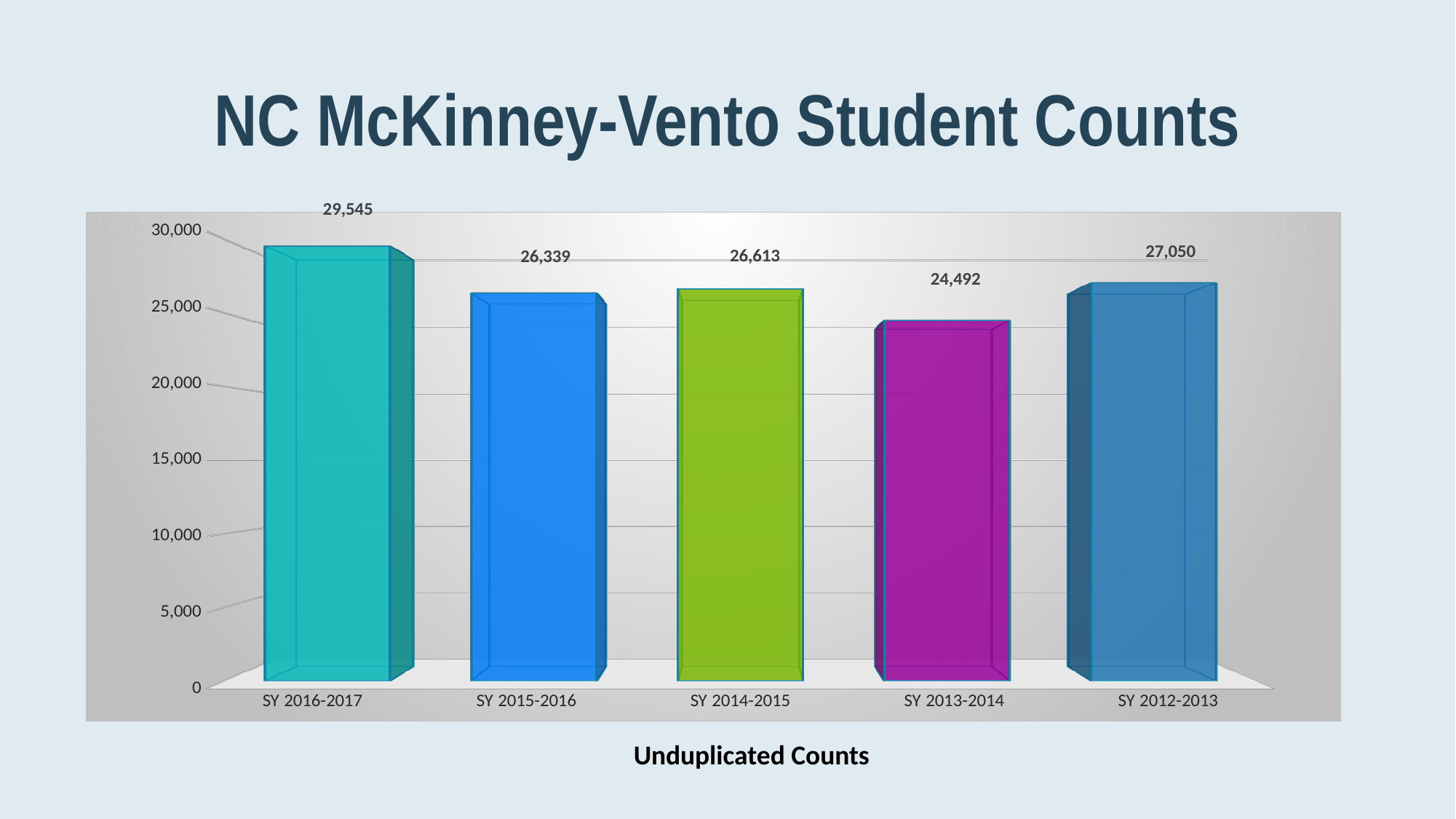
What is the difference between the student counts for SY 2012-2013 and SY 2013-2014? 2,558 Which is larger, the student count for SY 2014-2015 or SY 2015-2016? SY 2014-2015 What kind of chart is shown on the slide? bar chart How many school years are shown on the chart? 5 What is the student count for SY 2016-2017? 29,545 Which school year has the highest student count? SY 2016-2017 Which school year has the lowest student count? SY 2013-2014 What is the student count for SY 2012-2013? 27,050 What is the difference between the student counts for SY 2016-2017 and SY 2015-2016? 3,206 What is the student count for SY 2013-2014? 24,492 What is the title of the slide? NC McKinney-Vento Student Counts Is the value for SY 2013-2014 greater or less than 25,000? less